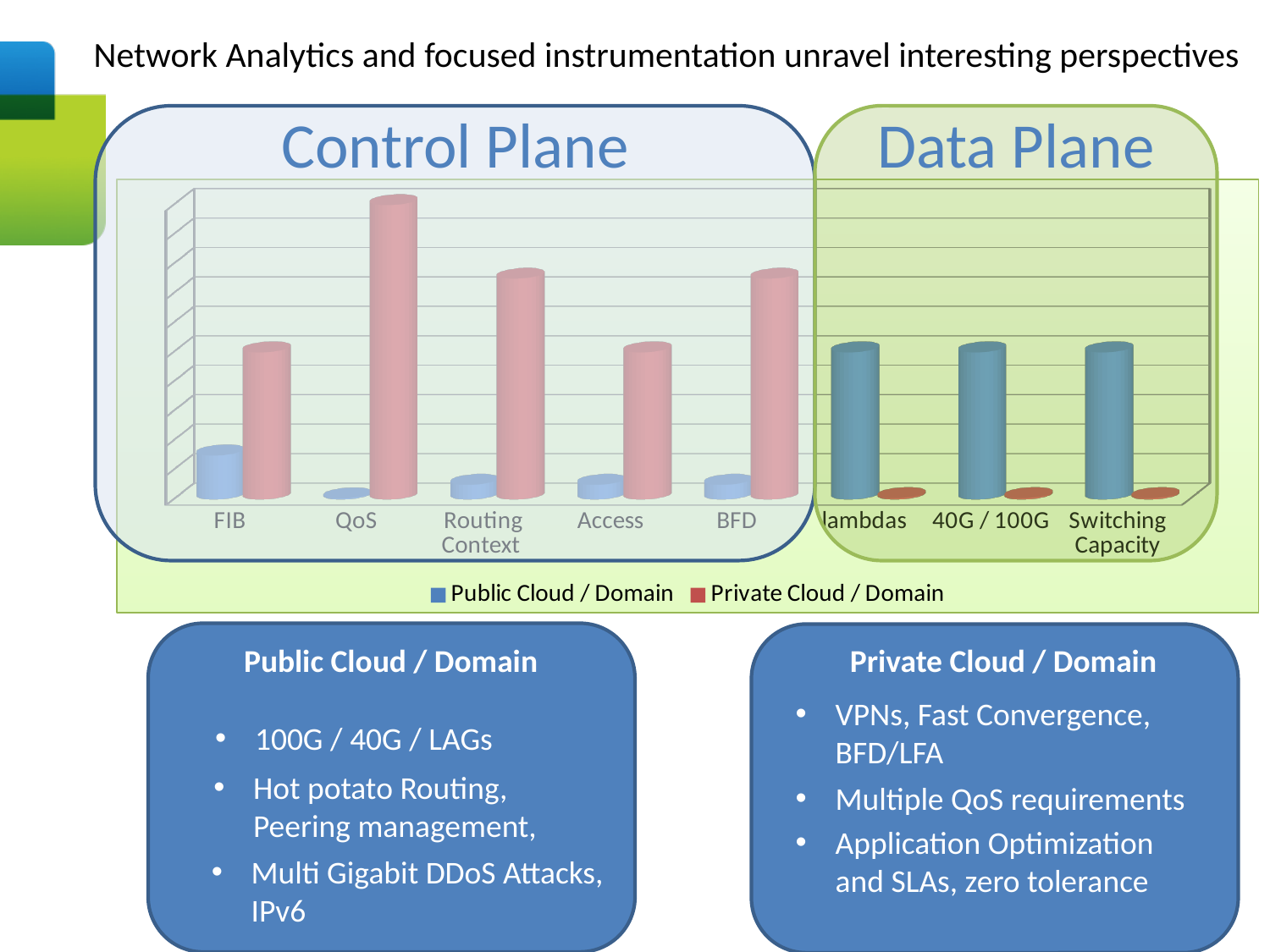
Which is larger, the Public Cloud / Domain bar for FIB or for QoS? FIB What are the two series named in the chart's legend? Public Cloud / Domain and Private Cloud / Domain How many categories are shown along the x axis of the chart? 8 For the BFD category, which series has the larger bar? Private Cloud / Domain Which category has the highest Private Cloud / Domain bar? QoS Which category has the lowest Public Cloud / Domain bar? QoS Which is larger, the Private Cloud / Domain bar for BFD or for Access? BFD What kind of chart is shown on the slide? Bar chart Which colour represents the Private Cloud / Domain series in the chart? Red How many series does the chart's legend list? 2